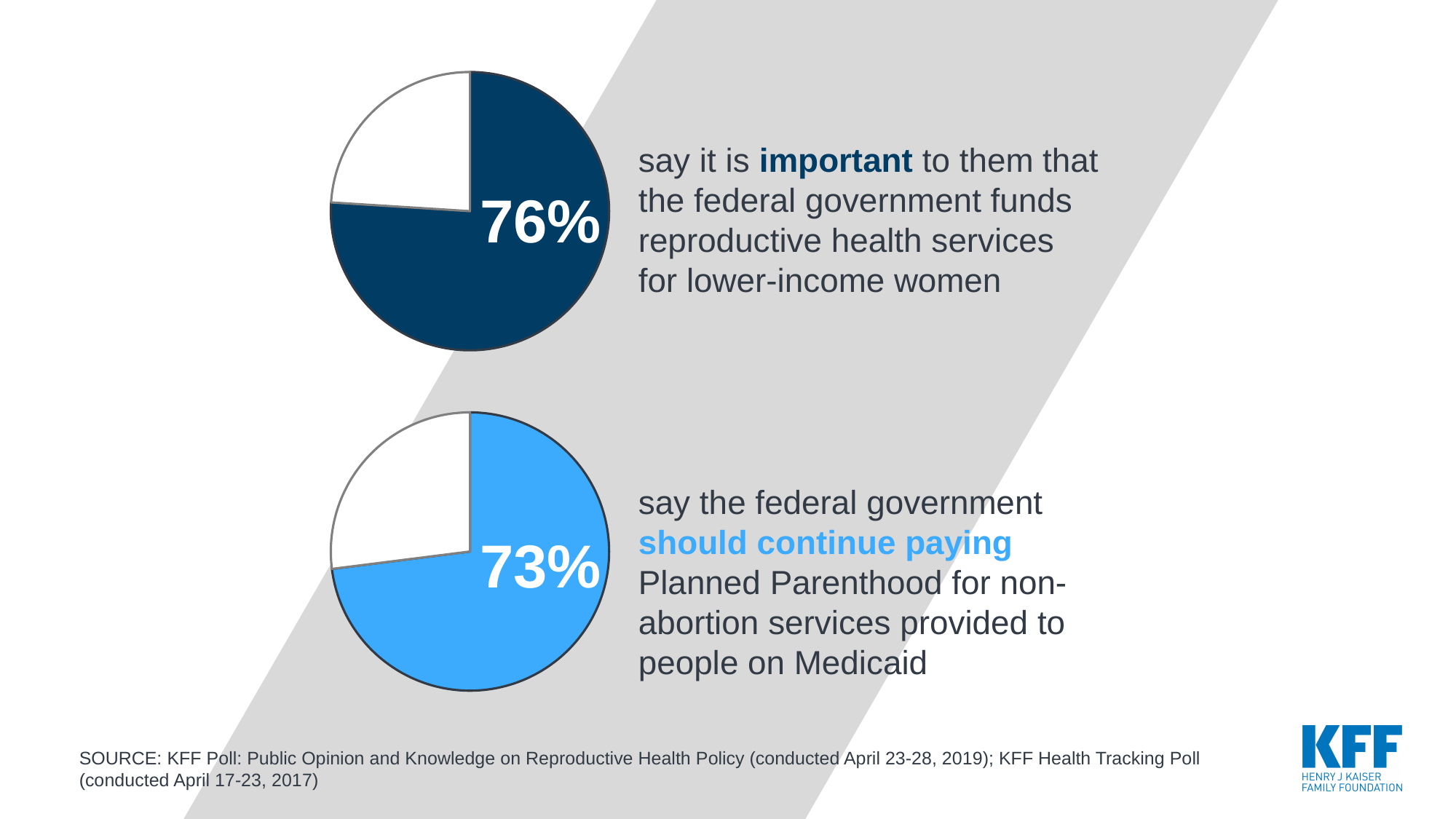
Which pie chart shows the larger labelled percentage, the top one or the bottom one? The top one What share of the bottom pie chart does the light blue slice represent? 73% What share of the top pie chart does the dark blue slice represent? 76% How many pie charts are on the slide? 2 In the bottom pie chart, which slice is larger, the light blue slice or the white slice? The light blue slice In the top pie chart, which slice is larger, the dark blue slice or the white slice? The dark blue slice What is the difference between the percentage labelled on the top pie chart and the percentage labelled on the bottom pie chart? 3 percentage points What colour is the labelled slice in the bottom pie chart? Light blue In the bottom pie chart, what percentage is shown for the light blue slice? 73% What kind of charts are shown on the slide? Pie charts In the top pie chart, what percentage is shown for the dark blue slice? 76% How many slices does each pie chart have? 2